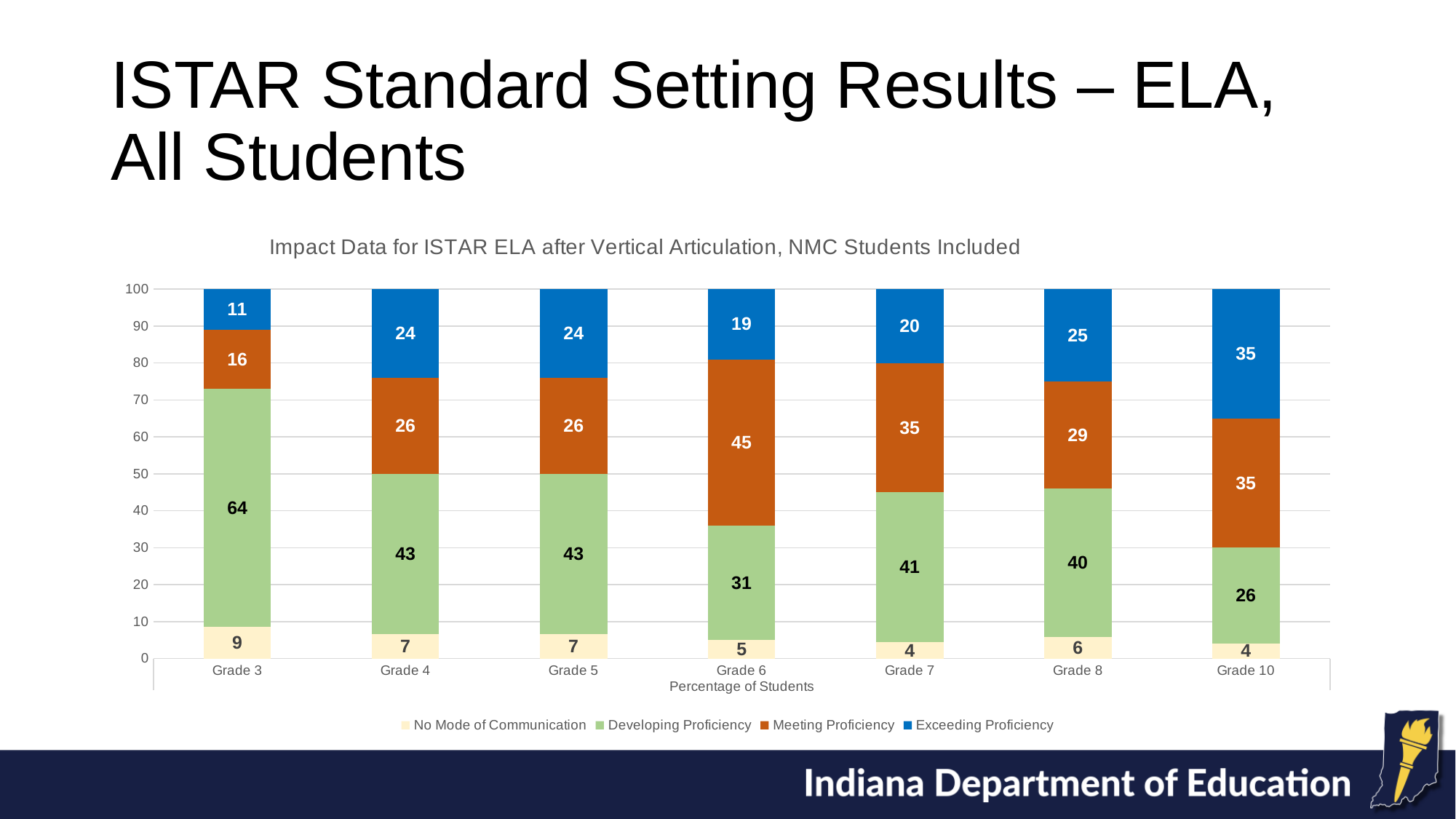
What is the No Mode of Communication value for Grade 8? 6 Which is larger, the Exceeding Proficiency value for Grade 8 or for Grade 6? Grade 8 Which grade has the highest Meeting Proficiency value? Grade 6 What is the Meeting Proficiency value for Grade 6? 45 What is the total of the stacked bar for Grade 7? 100 Which grade has the lowest Exceeding Proficiency value? Grade 3 What is the Exceeding Proficiency value for Grade 10? 35 What is the Developing Proficiency value for Grade 3? 64 How many grade categories are shown on the x axis? 7 What is the difference between the Developing Proficiency values for Grade 3 and Grade 10? 38 How many series does the legend list? 4 What kind of chart is shown on the slide? Stacked bar chart